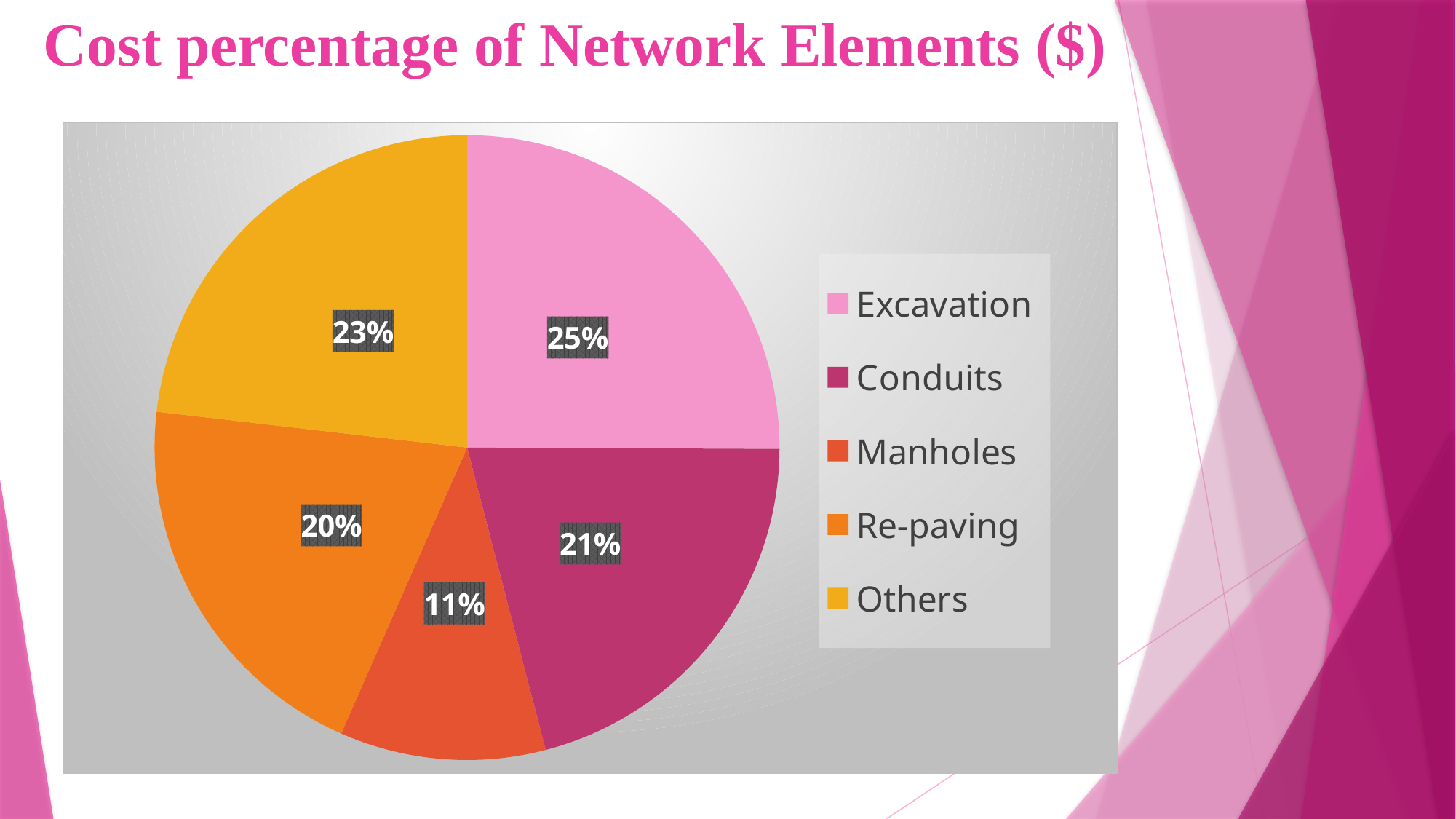
What percentage of the cost is attributed to Re-paving? 20% What is the title of the slide? Cost percentage of Network Elements ($) What percentage of the cost is attributed to Excavation? 25% Which has a larger cost percentage, Others or Re-paving? Others What percentage of the cost is attributed to Conduits? 21% Which network element has the smallest cost percentage? Manholes Which network element has the largest cost percentage? Excavation How many categories are shown in the pie chart? 5 What type of chart is shown on the slide? pie chart What percentage of the cost is attributed to Manholes? 11% What percentage of the cost is attributed to Others? 23% What is the difference in percentage points between Excavation and Manholes? 14